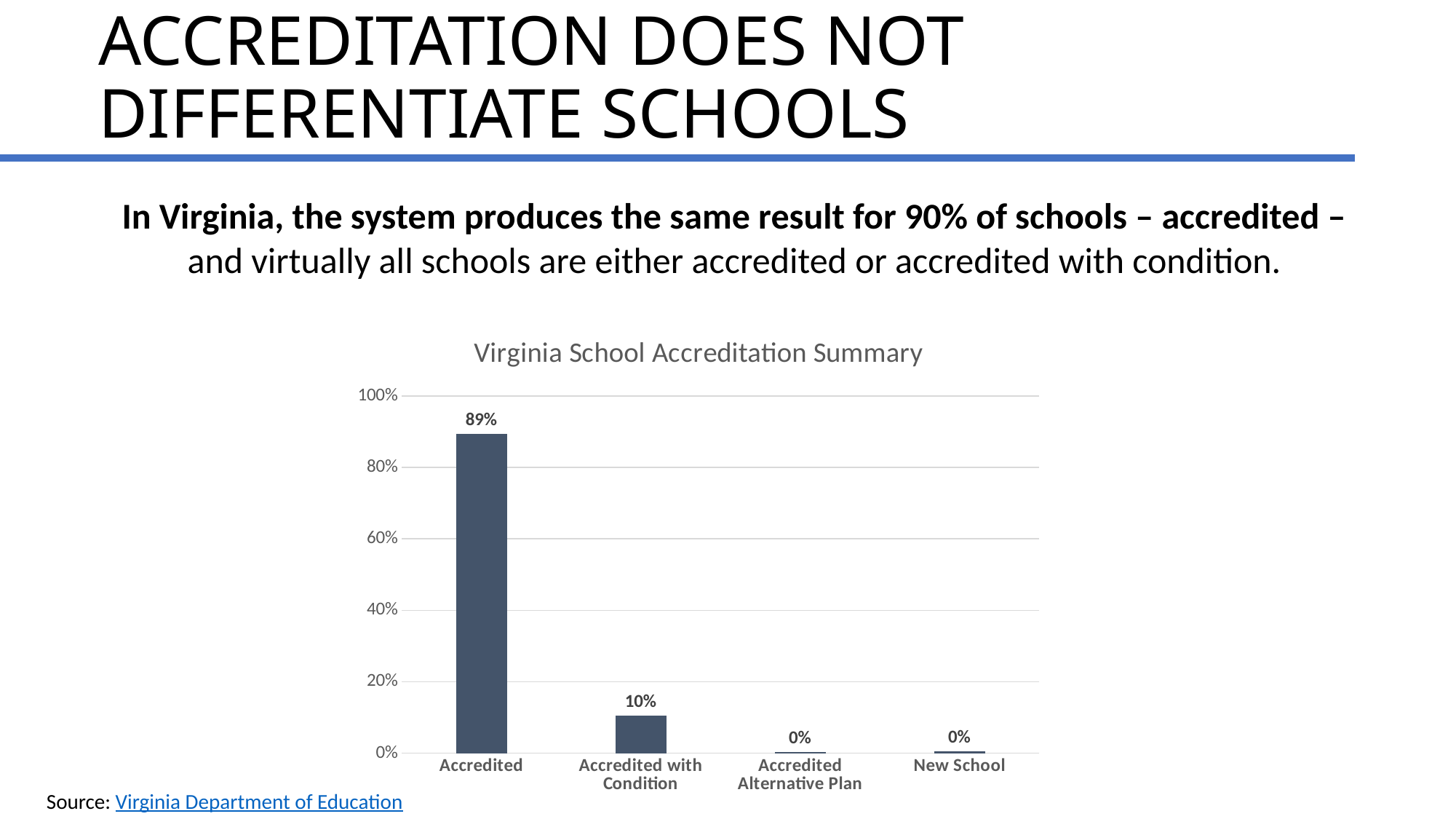
What kind of chart is shown on the slide? bar chart Is the value for Accredited greater or less than 80%? greater Which category has the highest value? Accredited What is the value for Accredited Alternative Plan? 0% What is the title of the chart? Virginia School Accreditation Summary What is the value for Accredited? 89% What is the difference between the values for Accredited and Accredited with Condition? 79% What is the value for Accredited with Condition? 10% How many categories are shown on the x axis? 4 Which is larger, the value for Accredited with Condition or the value for New School? Accredited with Condition What is the value for New School? 0%